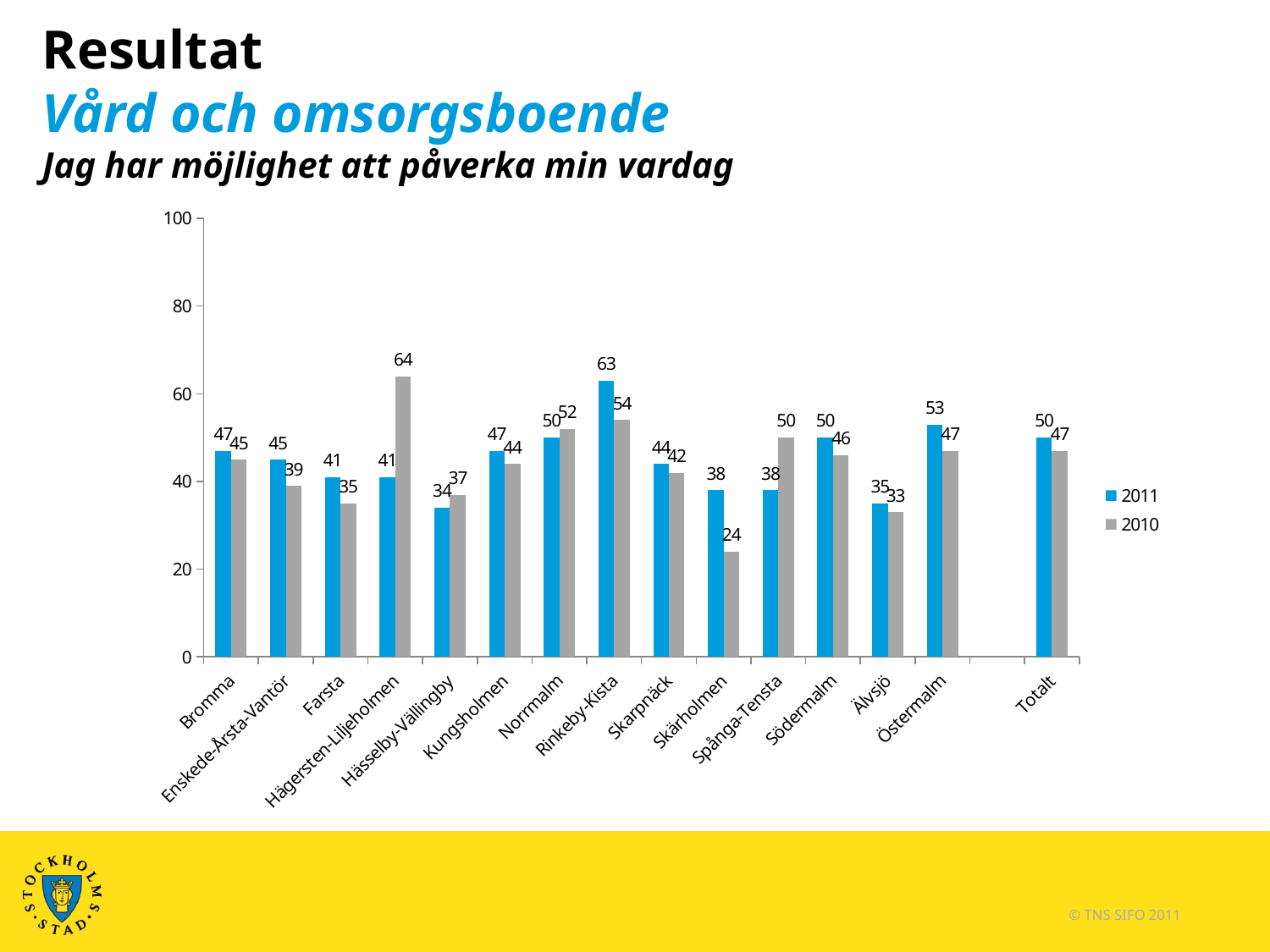
What is the difference between the 2011 and 2010 values for Skärholmen? 14 How many series does the legend list? 2 Which category has the lowest 2011 value? Hässelby-Vällingby Which is larger for Spånga-Tensta, the 2011 value or the 2010 value? 2010 How many categories are shown on the x axis? 15 Which category has the highest 2011 value? Rinkeby-Kista What is the 2011 value for Rinkeby-Kista? 63 Which colour represents the 2011 series? Blue What is the 2011 value for Totalt? 50 Which category has the lowest 2010 value? Skärholmen What is the 2010 value for Hägersten-Liljeholmen? 64 What kind of chart is shown on the slide? Bar chart